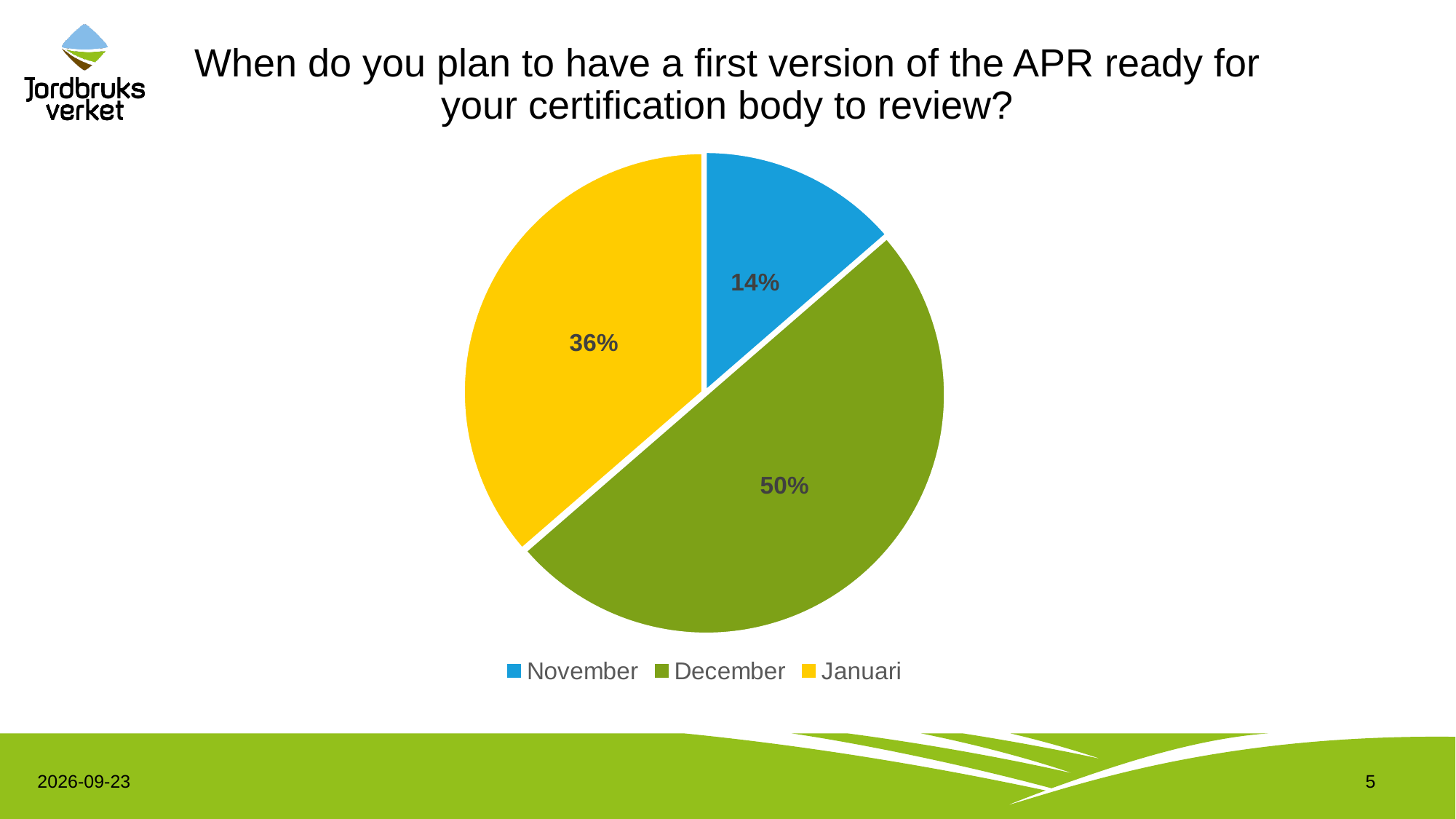
Which category has the smallest slice of the pie? November Which legend entry is shown in yellow? Januari Which category has the largest slice of the pie? December What share of the pie is Januari? 36% Which slice is larger, Januari or November? Januari What share of the pie is November? 14% What is the difference in percentage points between the Januari and November slices? 22 What colour is the December slice? Green How many categories does the pie chart show? 3 What share of the pie is December? 50% What is the difference in percentage points between the December and Januari slices? 14 What kind of chart is shown on the slide? Pie chart